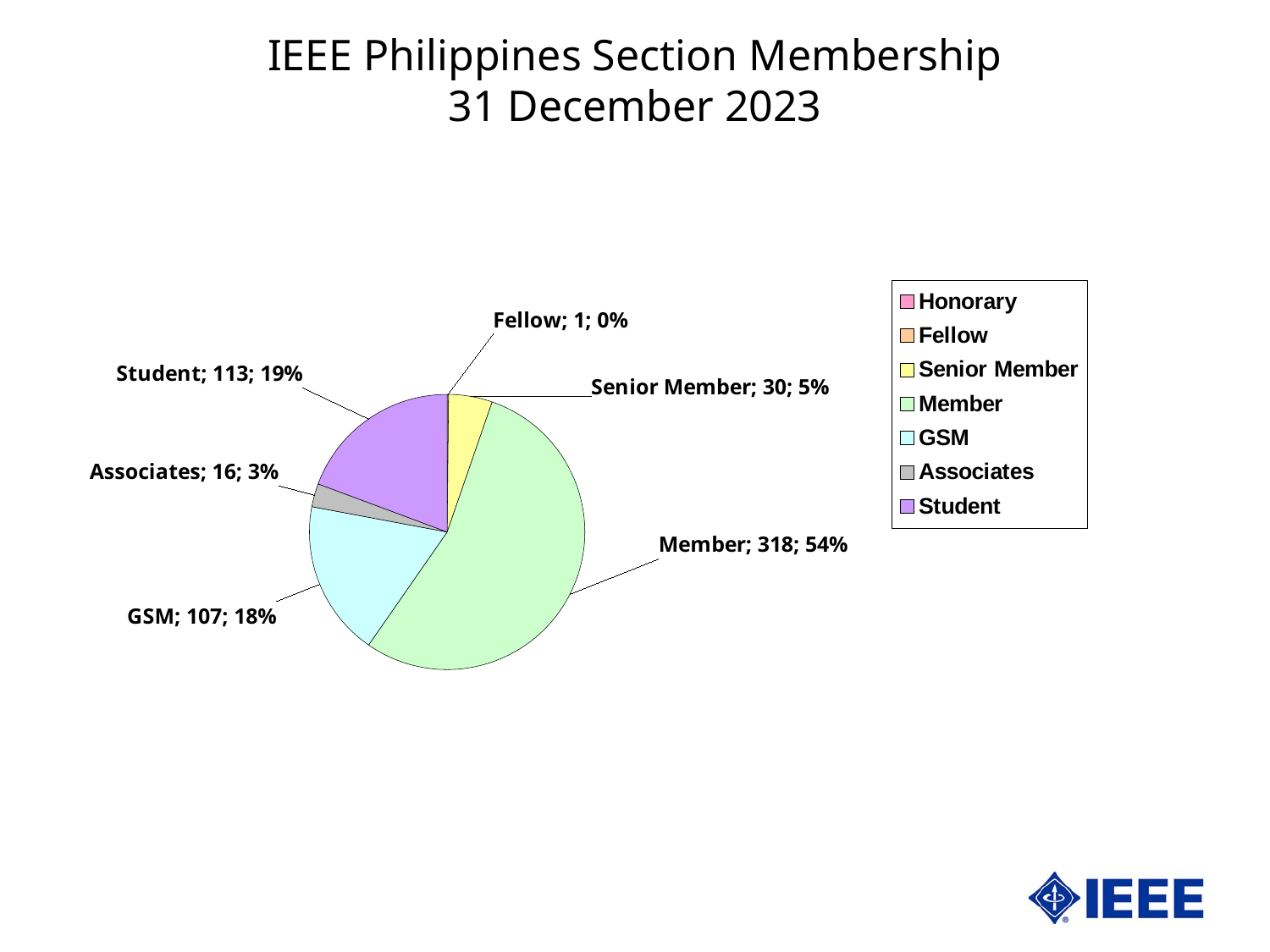
Which category has the largest slice of the pie? Member What percentage of membership is Senior Member? 5% How many members are in the Member category? 318 What kind of chart is shown on the slide? Pie chart What share of the pie does the Student slice represent? 19% What is the title of the chart on the slide? IEEE Philippines Section Membership 31 December 2023 What is the difference in count between Student and GSM? 6 Which labelled category has the smallest slice of the pie? Fellow How many members are in the Associates category? 16 How many entries does the legend list? 7 Which is larger, the Associates count or the Senior Member count? Senior Member How many members are in the GSM category? 107